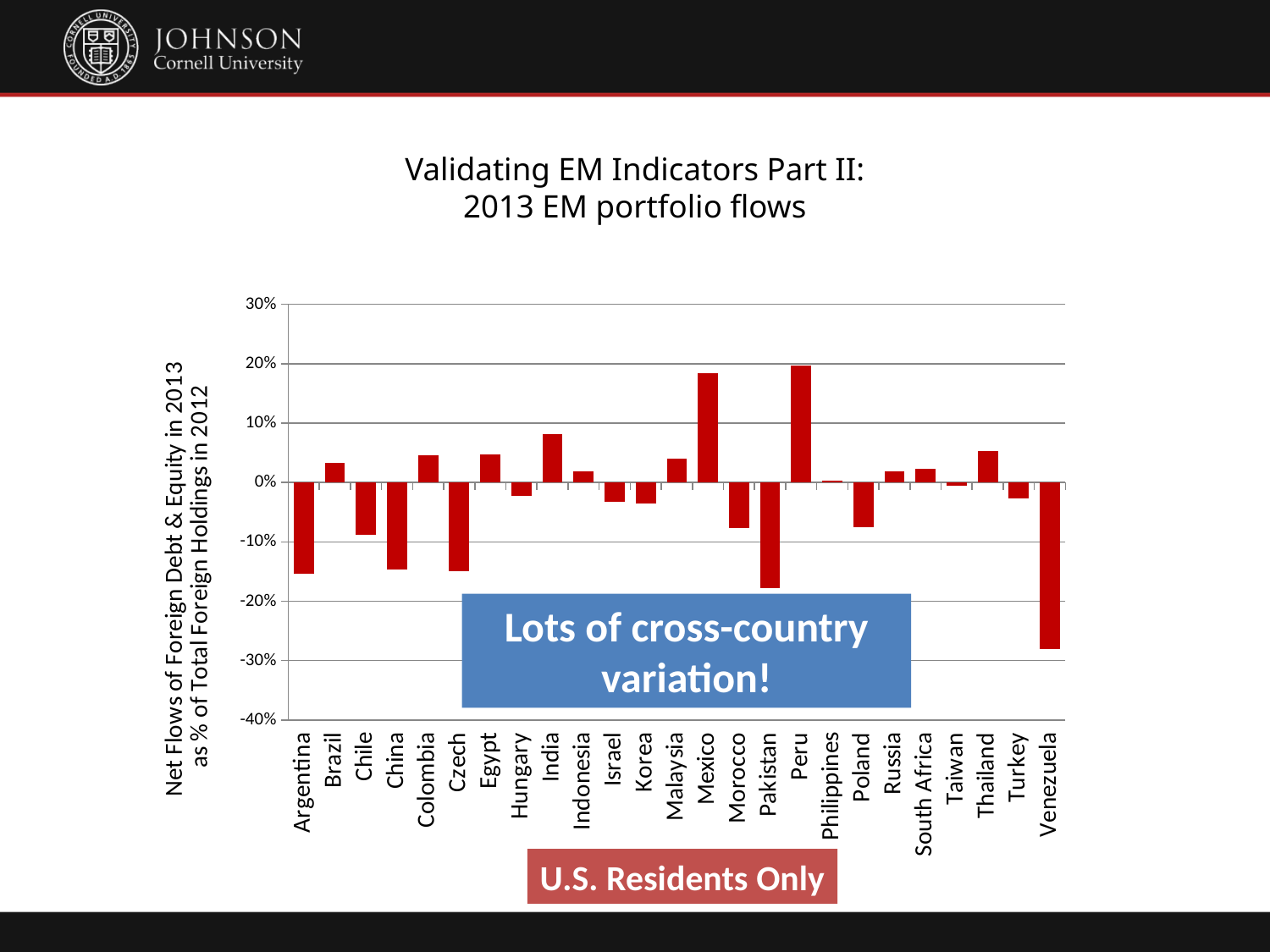
Which has the larger value, India or Brazil? India What is the y-axis title of the chart? Net Flows of Foreign Debt & Equity in 2013 as % of Total Foreign Holdings in 2012 What does the red label below the chart say? U.S. Residents Only How many countries are shown on the x axis of the chart? 25 Which has the larger value, Pakistan or Venezuela? Pakistan Is the value for Argentina greater or less than -10%? less Is the value for Venezuela greater or less than -20%? less Is the value for Pakistan greater or less than -10%? less What kind of chart is shown on the slide? bar chart Which country has the lowest value in the chart? Venezuela